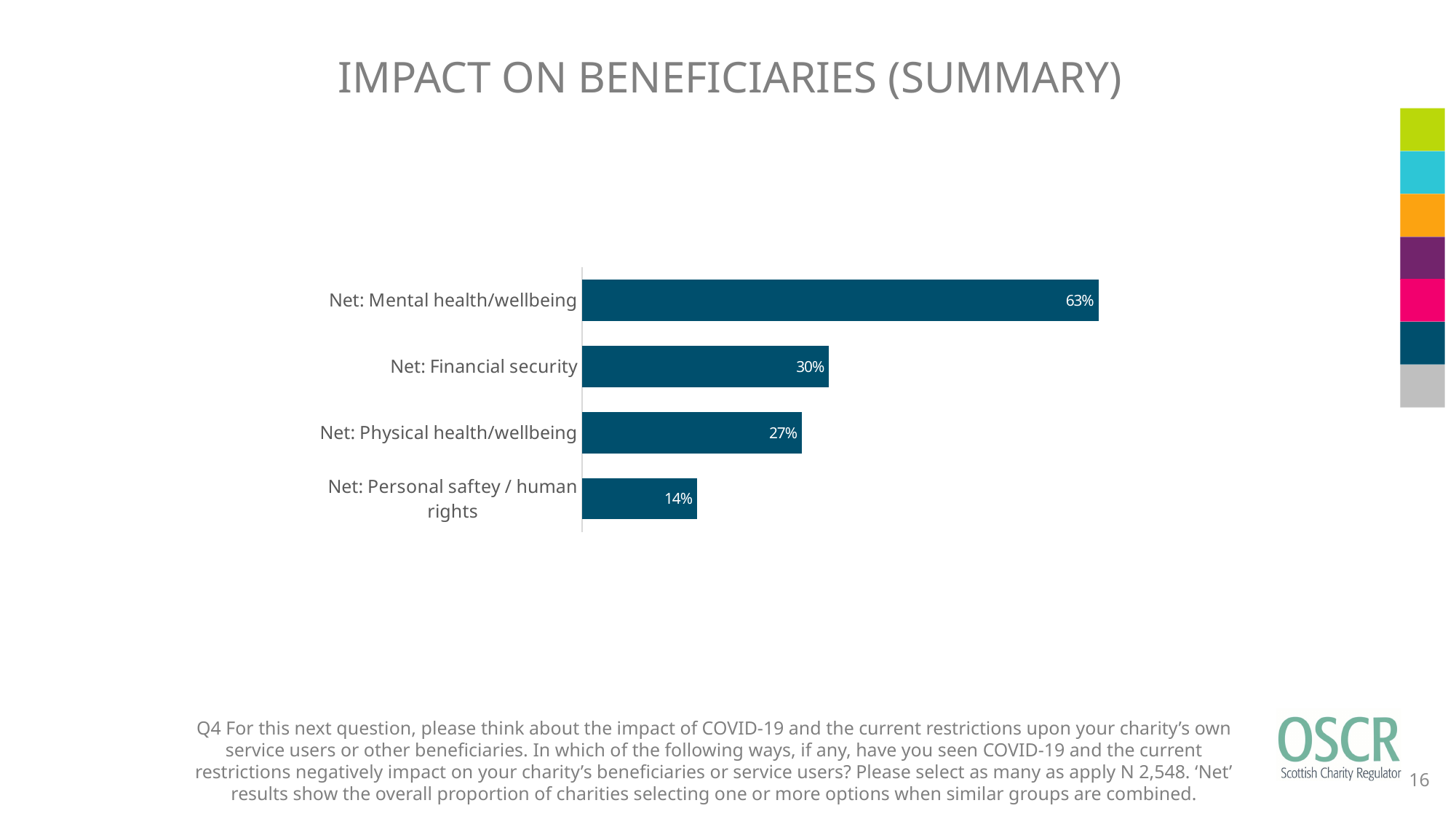
What kind of chart is shown on the slide? Bar chart Which is larger, the value for Net: Financial security or the value for Net: Physical health/wellbeing? Net: Financial security How many categories are shown in the chart? 4 Which category has the highest value? Net: Mental health/wellbeing What is the value for Net: Personal saftey / human rights? 14% Which category has the lowest value? Net: Personal saftey / human rights What is the difference between the values for Net: Physical health/wellbeing and Net: Personal saftey / human rights? 13% What is the value for Net: Financial security? 30% What is the difference between the values for Net: Mental health/wellbeing and Net: Financial security? 33% What is the title of the slide? IMPACT ON BENEFICIARIES (SUMMARY) What is the value for Net: Physical health/wellbeing? 27% What is the value for Net: Mental health/wellbeing? 63%